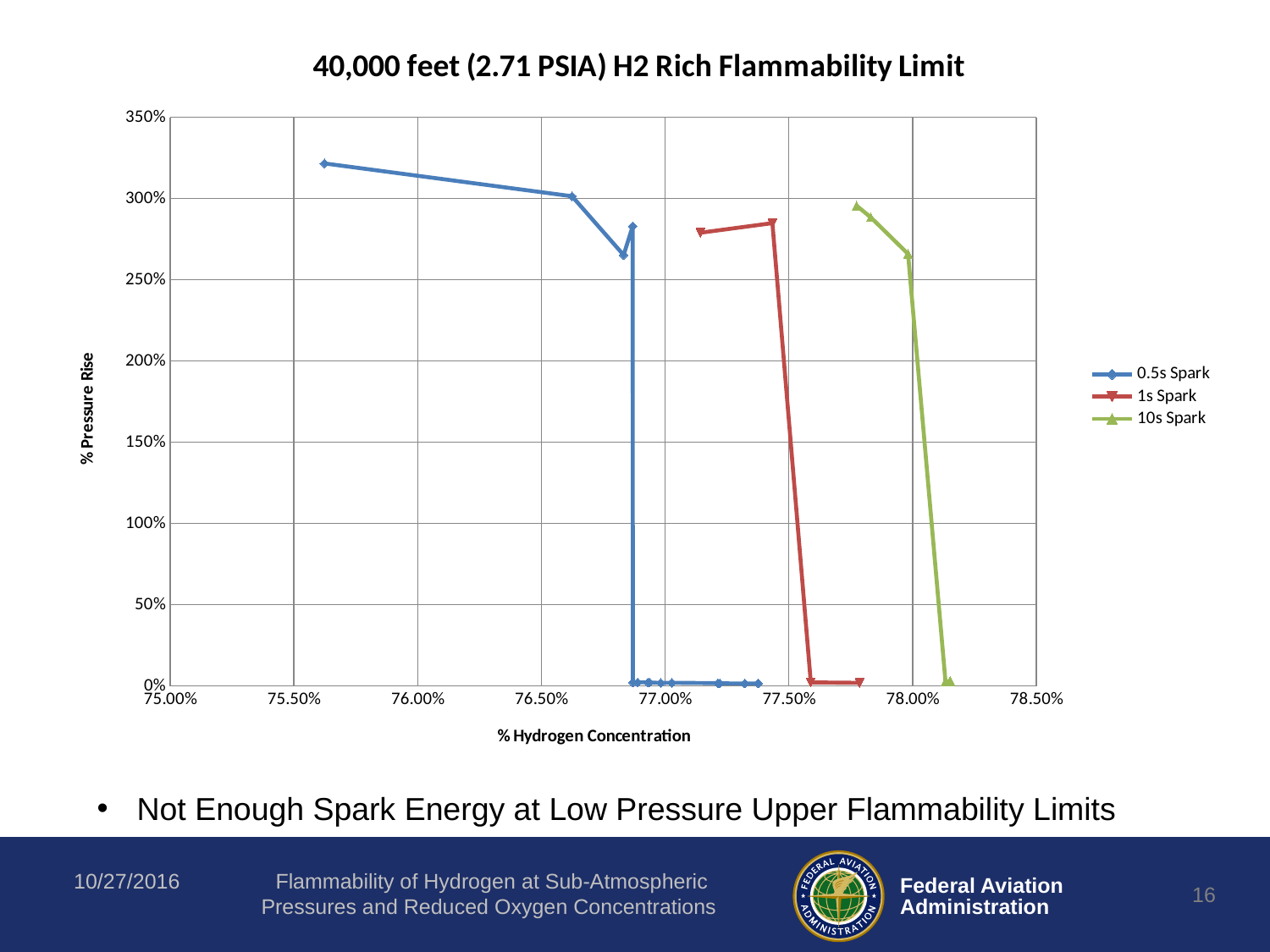
Is the % Hydrogen Concentration at which the 10s Spark series falls to 0% greater or less than 78.00%? greater Which series drops to 0% Pressure Rise at the highest % Hydrogen Concentration? 10s Spark Is the highest % Pressure Rise reached by the 0.5s Spark series greater or less than 300%? greater What are the three series named in the legend? 0.5s Spark, 1s Spark, 10s Spark Which series reaches the highest % Pressure Rise on the chart? 0.5s Spark What kind of chart is shown on the slide? line chart How many series does the legend list? 3 For the 0.5s Spark series, does % Pressure Rise increase or decrease as % Hydrogen Concentration increases? decrease Which series drops to 0% Pressure Rise at the lowest % Hydrogen Concentration? 0.5s Spark Is the highest % Pressure Rise reached by the 1s Spark series greater or less than 300%? less What is the title of the chart? 40,000 feet (2.71 PSIA) H2 Rich Flammability Limit